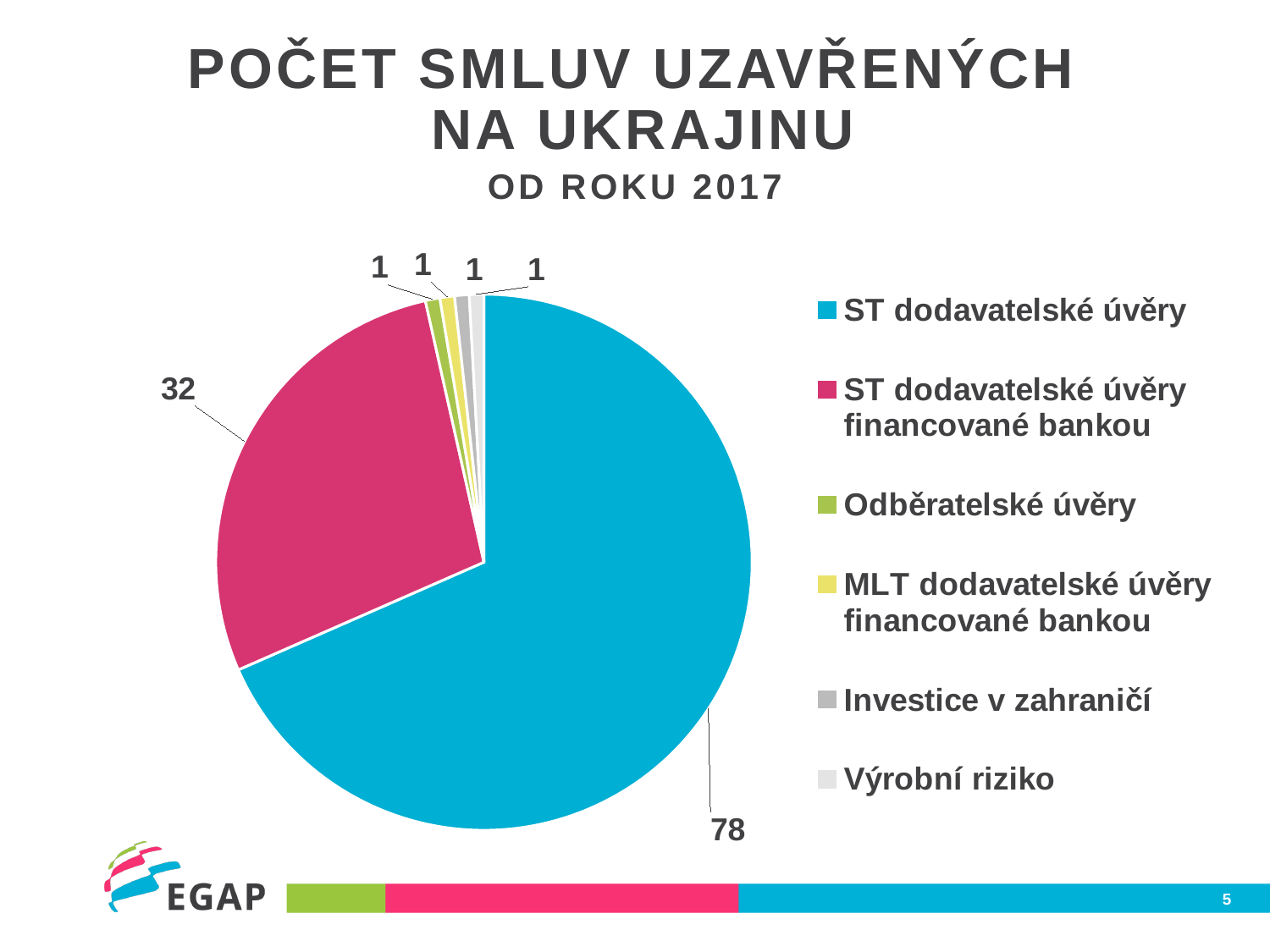
What value is shown for Odběratelské úvěry? 1 How many contracts are shown for ST dodavatelské úvěry? 78 Which category has the largest slice of the pie? ST dodavatelské úvěry How many entries does the legend list? 6 How many categories does the pie chart contain? 6 What is the difference between the values for ST dodavatelské úvěry and ST dodavatelské úvěry financované bankou? 46 Which is larger: ST dodavatelské úvěry financované bankou or Investice v zahraničí? ST dodavatelské úvěry financované bankou What is the title of the chart on the slide? POČET SMLUV UZAVŘENÝCH NA UKRAJINU OD ROKU 2017 What is the total of all values shown in the pie chart? 114 What colour is the slice for ST dodavatelské úvěry financované bankou? pink What type of chart is shown on the slide? pie chart How many contracts are shown for ST dodavatelské úvěry financované bankou? 32